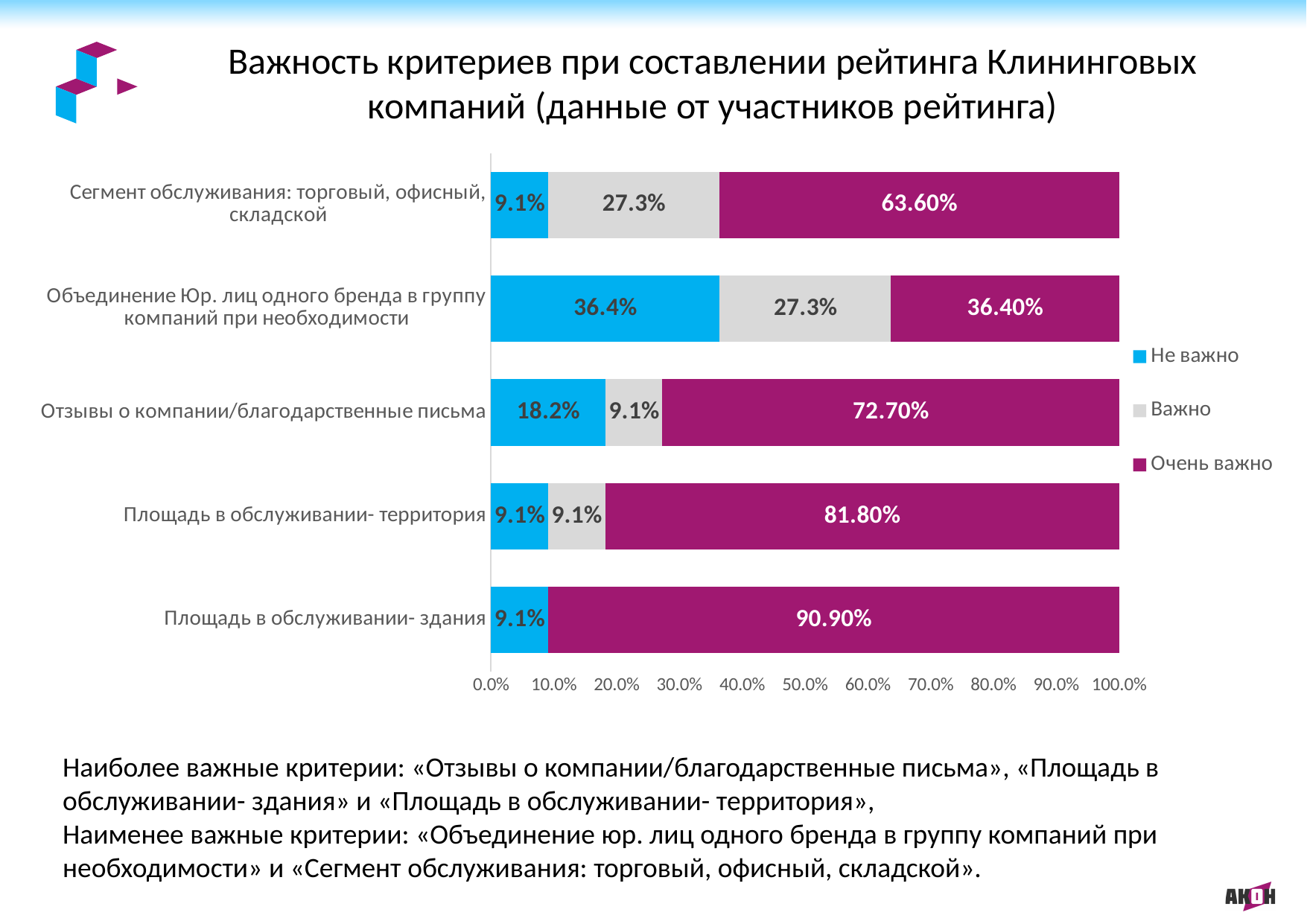
How many criteria (categories) are plotted in the chart? 5 What is the 'Не важно' value for 'Объединение Юр. лиц одного бренда в группу компаний при необходимости'? 36.4% What is the 'Важно' value for 'Сегмент обслуживания: торговый, офисный, складской'? 27.3% How many series does the legend list? 3 What type of chart is shown on the slide? Stacked bar chart What is the 'Не важно' value for 'Отзывы о компании/благодарственные письма'? 18.2% What is the difference between the 'Очень важно' values for 'Площадь в обслуживании- территория' and 'Отзывы о компании/благодарственные письма'? 9.10% Which is larger: the 'Не важно' value for 'Отзывы о компании/благодарственные письма' or for 'Площадь в обслуживании- территория'? Отзывы о компании/благодарственные письма Which legend entry is shown in magenta (purple)? Очень важно Which criterion has the lowest 'Очень важно' value? Объединение Юр. лиц одного бренда в группу компаний при необходимости What is the 'Очень важно' value for 'Площадь в обслуживании- здания'? 90.90% Which criterion has the highest 'Очень важно' value? Площадь в обслуживании- здания